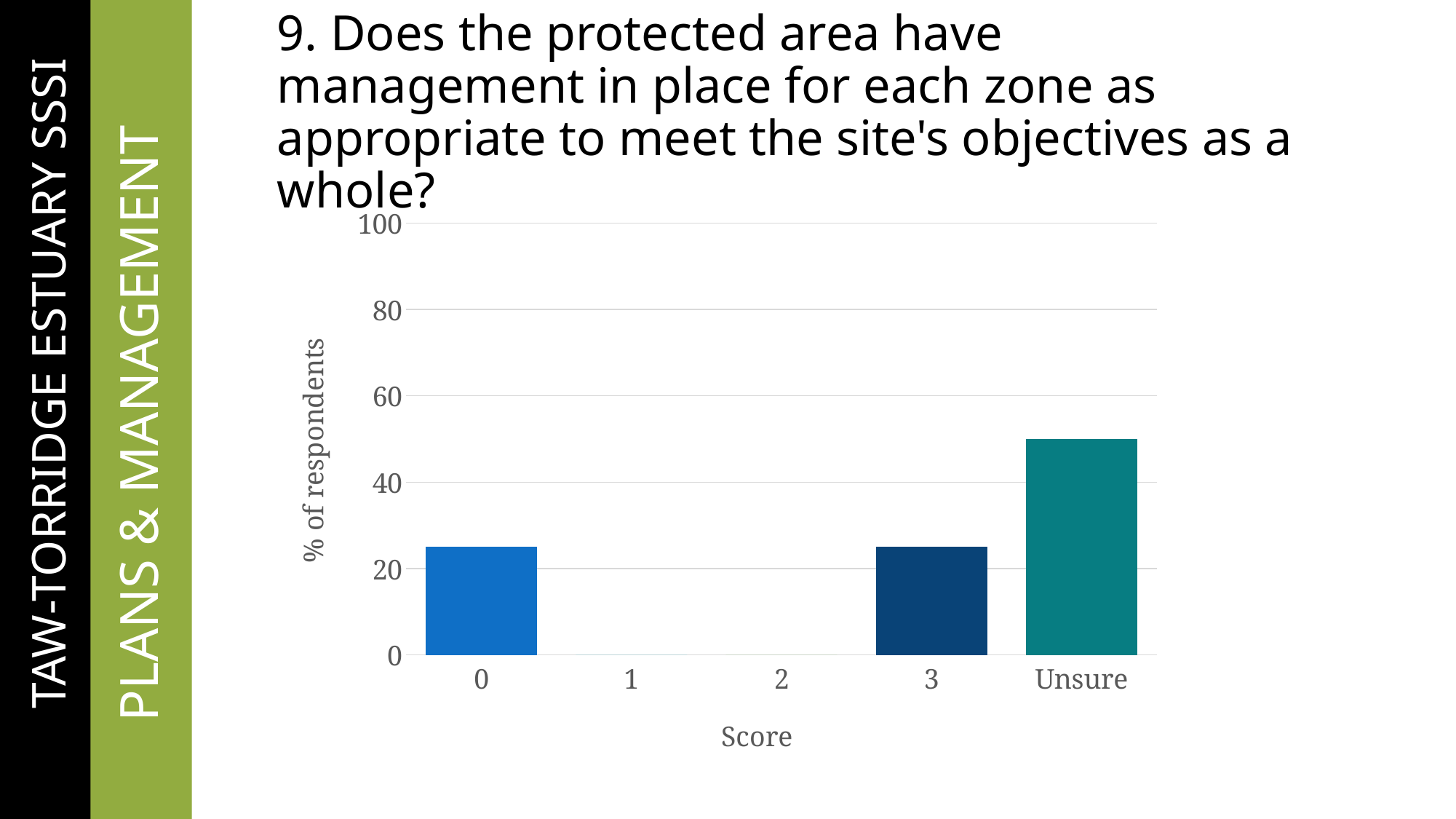
Is the value for Unsure greater or less than 40? greater How many score categories are shown on the x axis? 5 What is the label of the y axis? % of respondents Which is larger, the value for Unsure or the value for score 3? Unsure What percentage of respondents gave a score of 2? 0 What kind of chart is shown on the slide? bar chart Is the value for score 3 greater or less than 20? greater Is the value for score 0 greater or less than 40? less Which score category has the highest percentage of respondents? Unsure What percentage of respondents gave a score of 1? 0 What is the label of the x axis? Score